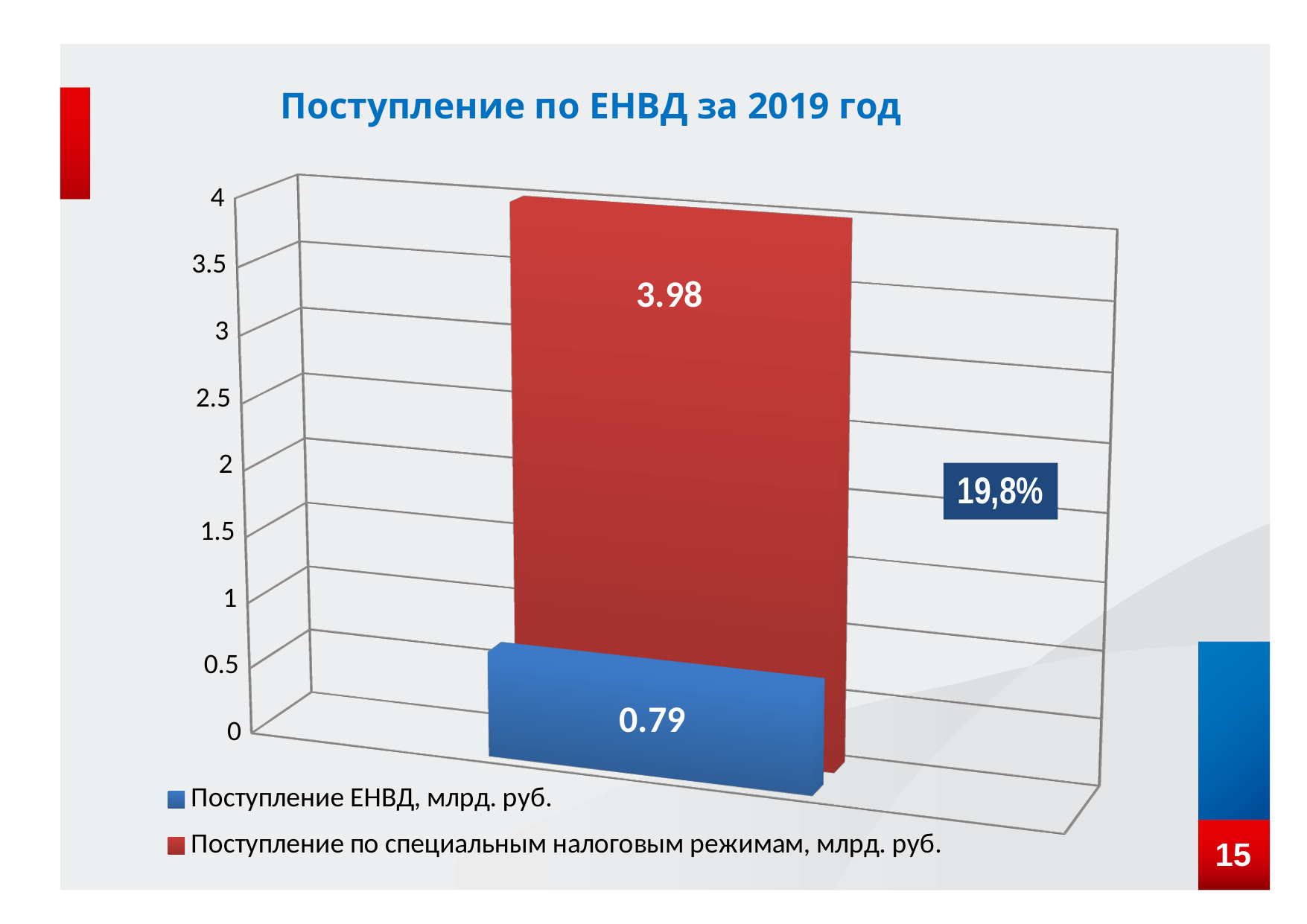
What percentage is shown in the label box to the right of the bars? 19,8% What is the value for Поступление ЕНВД, млрд. руб.? 0.79 What is the title of the chart? Поступление по ЕНВД за 2019 год Which series has the higher value? Поступление по специальным налоговым режимам, млрд. руб. Is the value for Поступление ЕНВД larger or smaller than the value for Поступление по специальным налоговым режимам? smaller Is the value for Поступление ЕНВД greater or less than 1? less Which series has the lower value? Поступление ЕНВД, млрд. руб. What kind of chart is shown on the slide? bar chart What is the value for Поступление по специальным налоговым режимам, млрд. руб.? 3.98 Is the value for Поступление по специальным налоговым режимам greater or less than 3.5? greater How many series does the legend list? 2 What is the difference between the value for Поступление по специальным налоговым режимам and the value for Поступление ЕНВД? 3.19